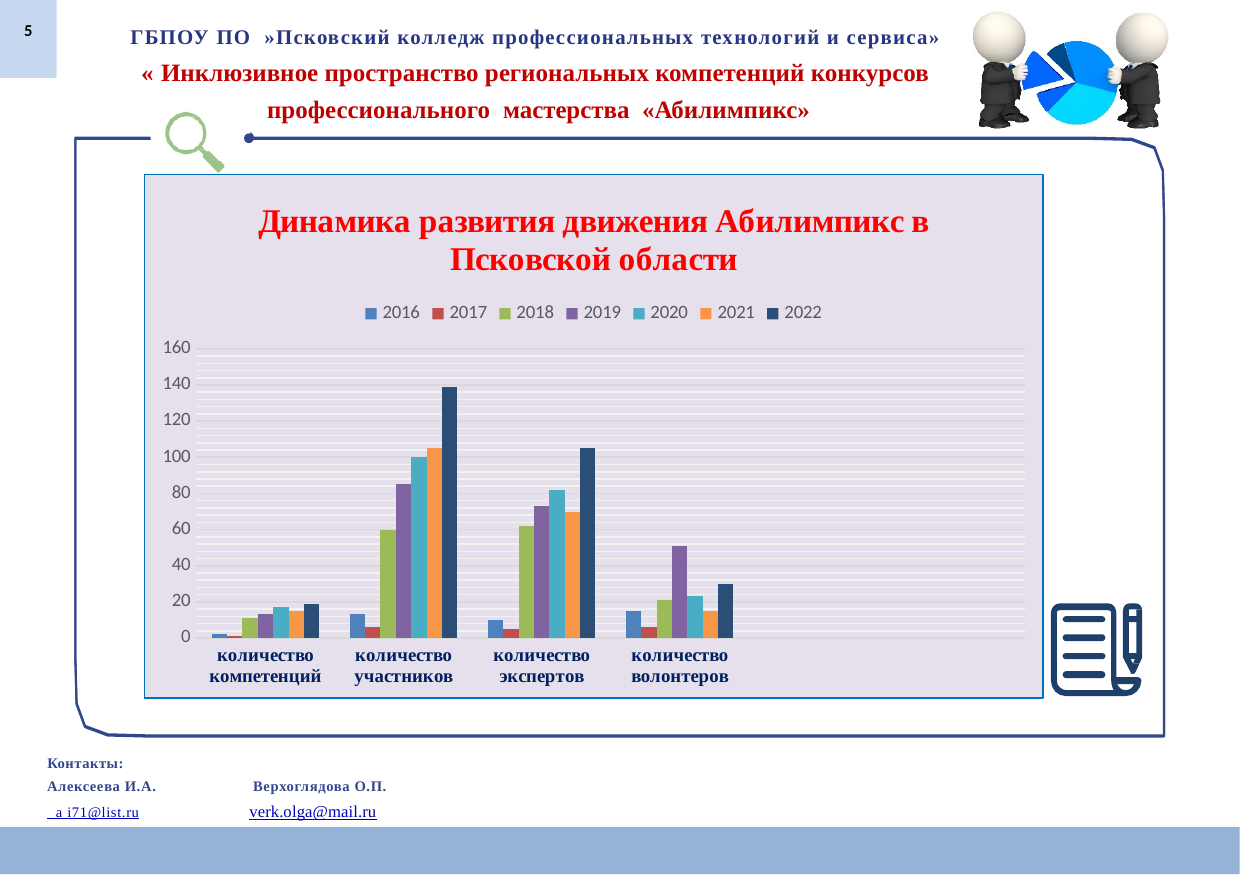
Is the value for 2022 in the category 'количество участников' greater or less than 120? greater How many categories are shown on the x axis? 4 What kind of chart is shown on the slide? bar chart How many series does the legend list? 7 What is the title of the chart? Динамика развития движения Абилимпикс в Псковской области Which year has the lowest bar in the category 'количество участников'? 2017 Which category has the highest bar for 2022? количество участников Is the value for 2020 in the category 'количество участников' greater or less than 80? greater Which year has the highest bar in the category 'количество волонтеров'? 2019 Which is larger for 2022: 'количество экспертов' or 'количество волонтеров'? количество экспертов In the category 'количество участников', do the bars rise or fall from 2018 to 2022? rise Is the value for 2019 in the category 'количество волонтеров' greater or less than 40? greater